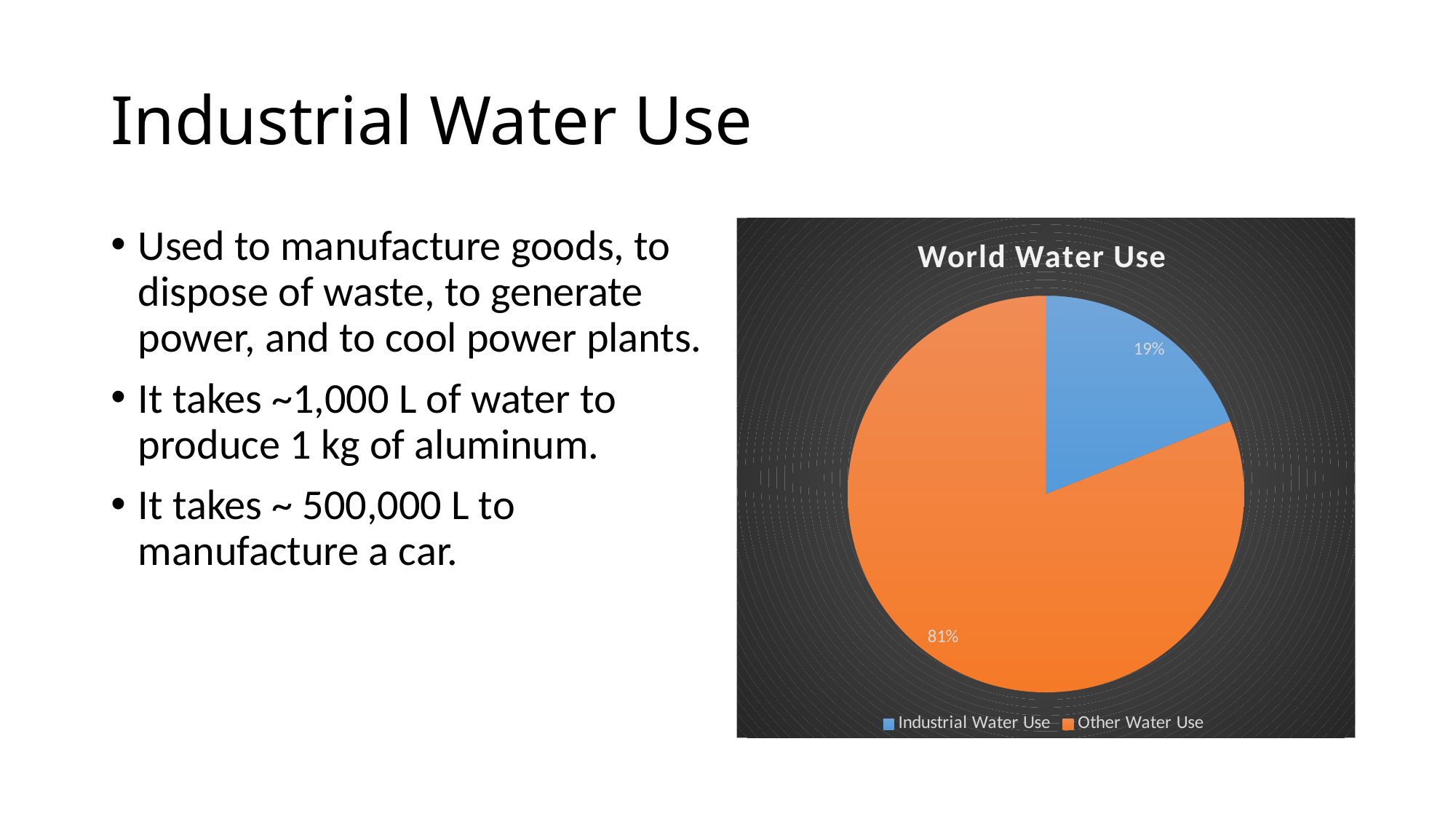
Which category has the smallest slice of the pie? Industrial Water Use Which category has the largest slice of the pie? Other Water Use How many categories does the pie chart show? 2 What colour is the Industrial Water Use slice? blue Which is larger, Industrial Water Use or Other Water Use? Other Water Use What kind of chart is shown on the slide? pie chart What share of world water use is Other Water Use? 81% How many entries does the legend list? 2 What is the total of the two slices shown? 100% What is the title of the chart? World Water Use What share of world water use is Industrial Water Use? 19% What is the difference in percentage points between Other Water Use and Industrial Water Use? 62